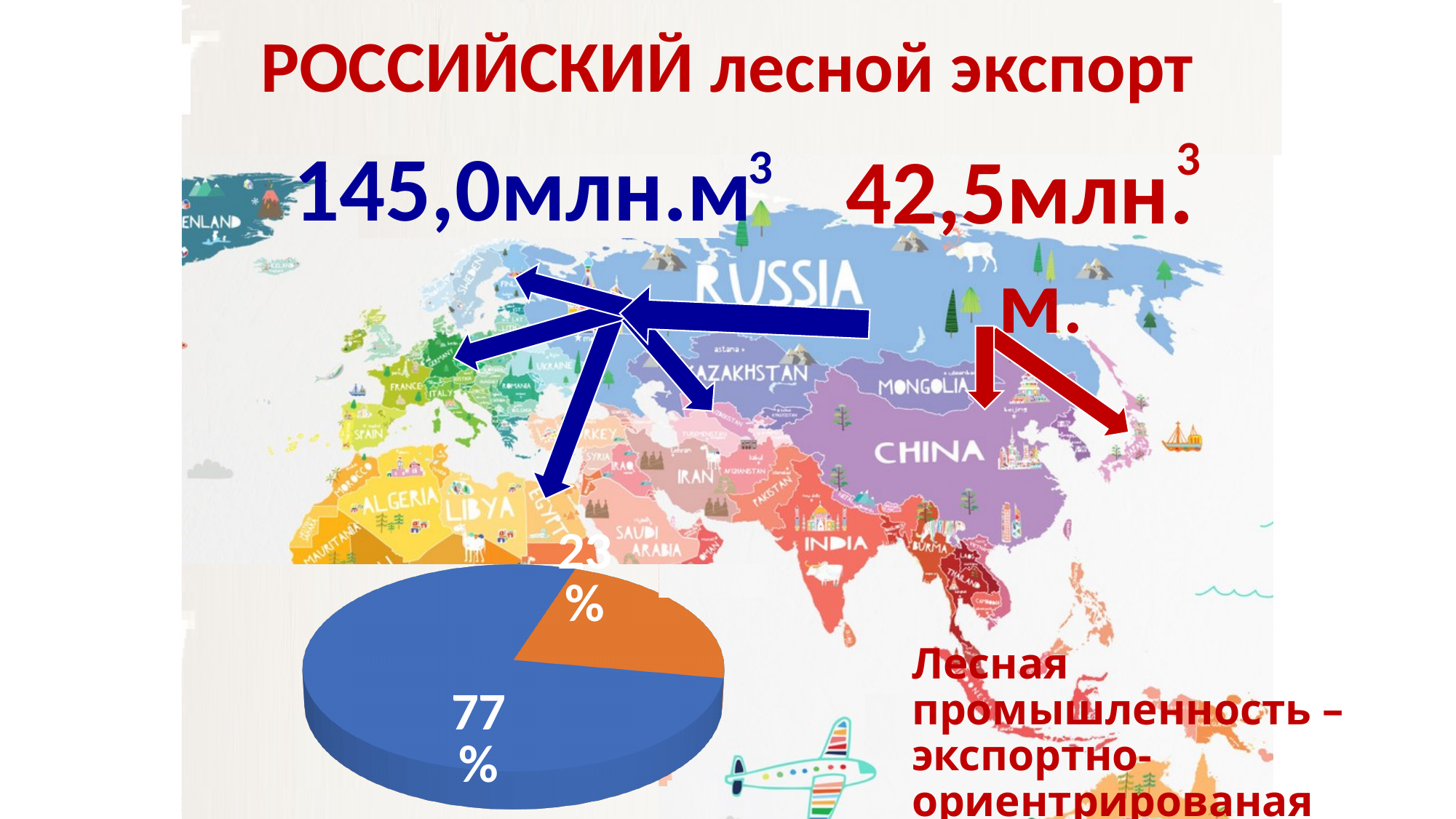
Which slice is larger, the blue one or the orange one? The blue one What kind of chart is shown on the slide? Pie chart What is the title of the slide containing the pie chart? РОССИЙСКИЙ лесной экспорт What two colours are used for the slices of the pie chart? Blue and orange How many slices does the pie chart have? 2 Which slice of the pie chart is the smallest? The orange slice (23%) What percentage is shown on the orange slice of the pie chart? 23% What is the difference in percentage points between the blue slice and the orange slice? 54 percentage points Which slice of the pie chart is the largest? The blue slice (77%) Is the blue slice's share greater or less than 50%? greater What do the two slices of the pie chart add up to? 100% What percentage is shown on the blue slice of the pie chart? 77%